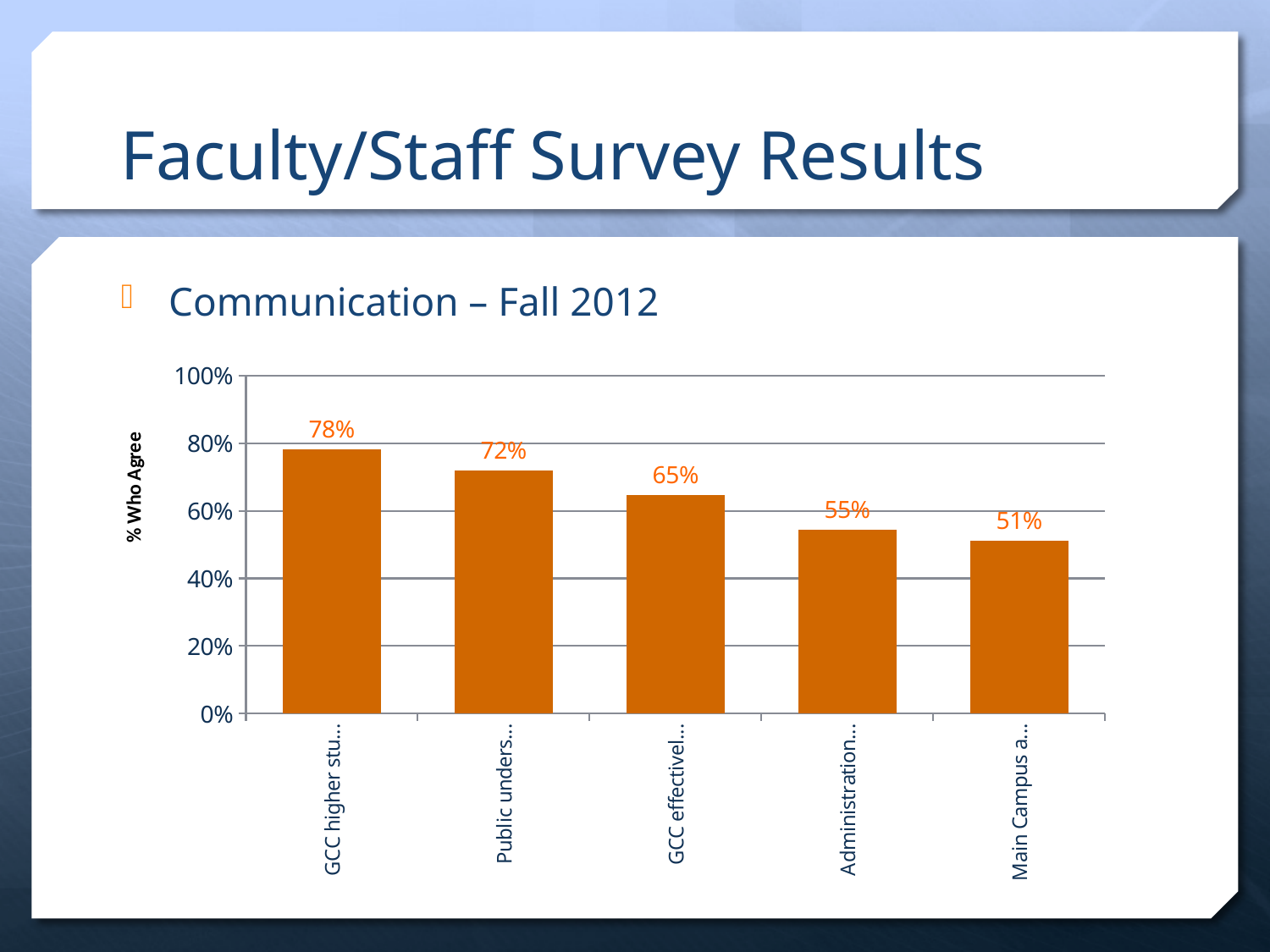
What is the value of the last bar, labelled "Main Campus a..."? 51% Which bar has the lowest value? Main Campus a... What is the value of the bar labelled "Administration..."? 55% Which bar has the highest value? GCC higher stu... What is the difference between the first bar (78%) and the last bar (51%)? 27% What is the value of the bar labelled "GCC effectivel..."? 65% What is the value of the first bar, labelled "GCC higher stu..."? 78% How many bars are plotted in the chart? 5 Do the bar values rise or fall from left to right along the x axis? fall What is the label of the vertical axis? % Who Agree What kind of chart is shown on the slide? bar chart What is the value of the bar labelled "Public unders..."? 72%